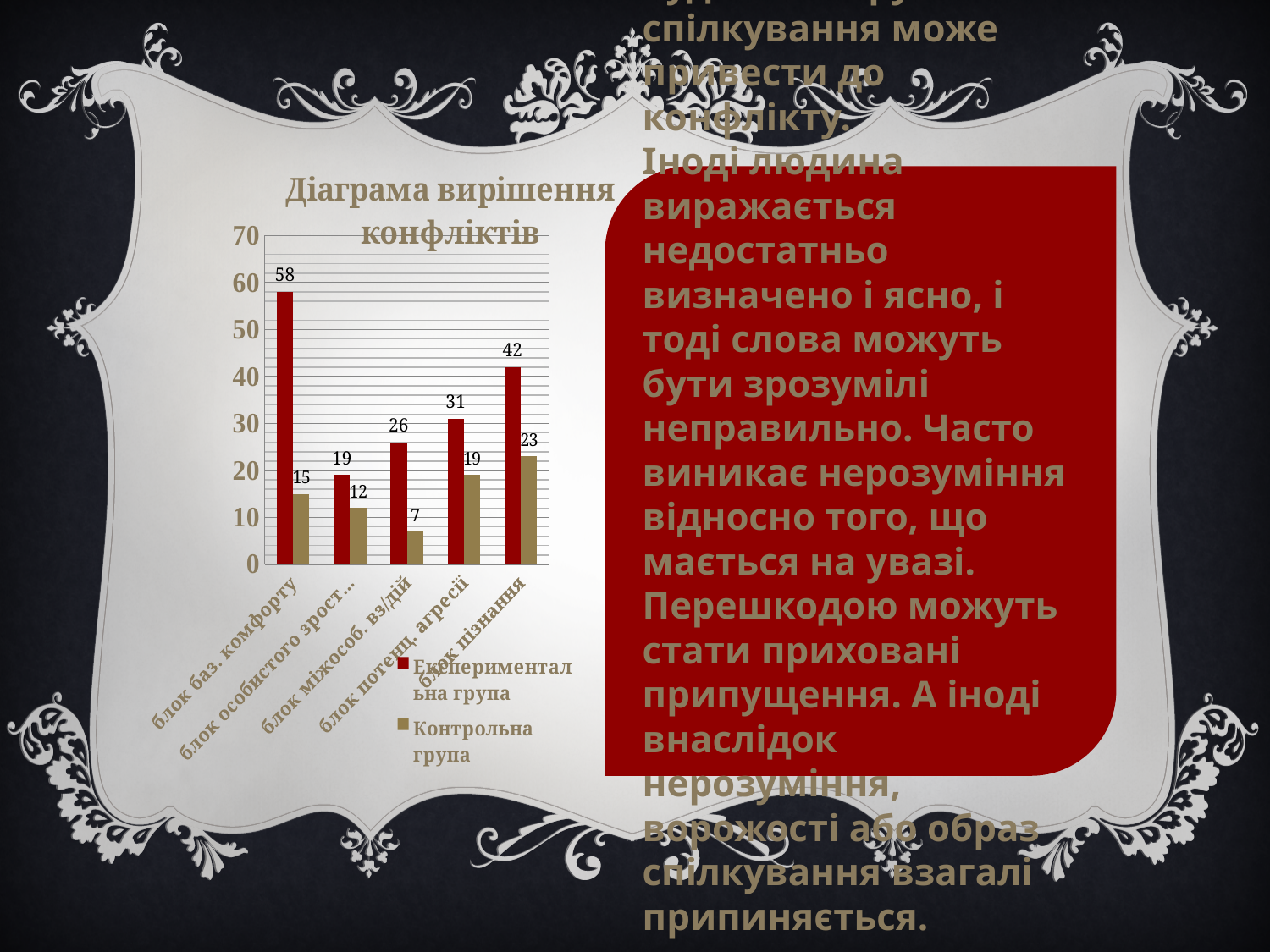
Which category has the highest value for Експериментальна група? блок баз. комфорту Which colour represents Контрольна група in the chart? tan (gold-brown) How many series does the legend list? 2 Which is larger in the category блок пізнання: Експериментальна група or Контрольна група? Експериментальна група What is the difference between Експериментальна група and Контрольна група in the category блок потенц. агресії? 12 What is the value for Експериментальна група in the category блок баз. комфорту? 58 What is the value for Контрольна група in the category блок міжособ. вз/дій? 7 What type of chart is shown on the slide? bar chart What is the chart's title? Діаграма вирішення конфліктів Which category has the lowest value for Контрольна група? блок міжособ. вз/дій What is the value for Контрольна група in the category блок пізнання? 23 How many categories are shown on the x axis? 5